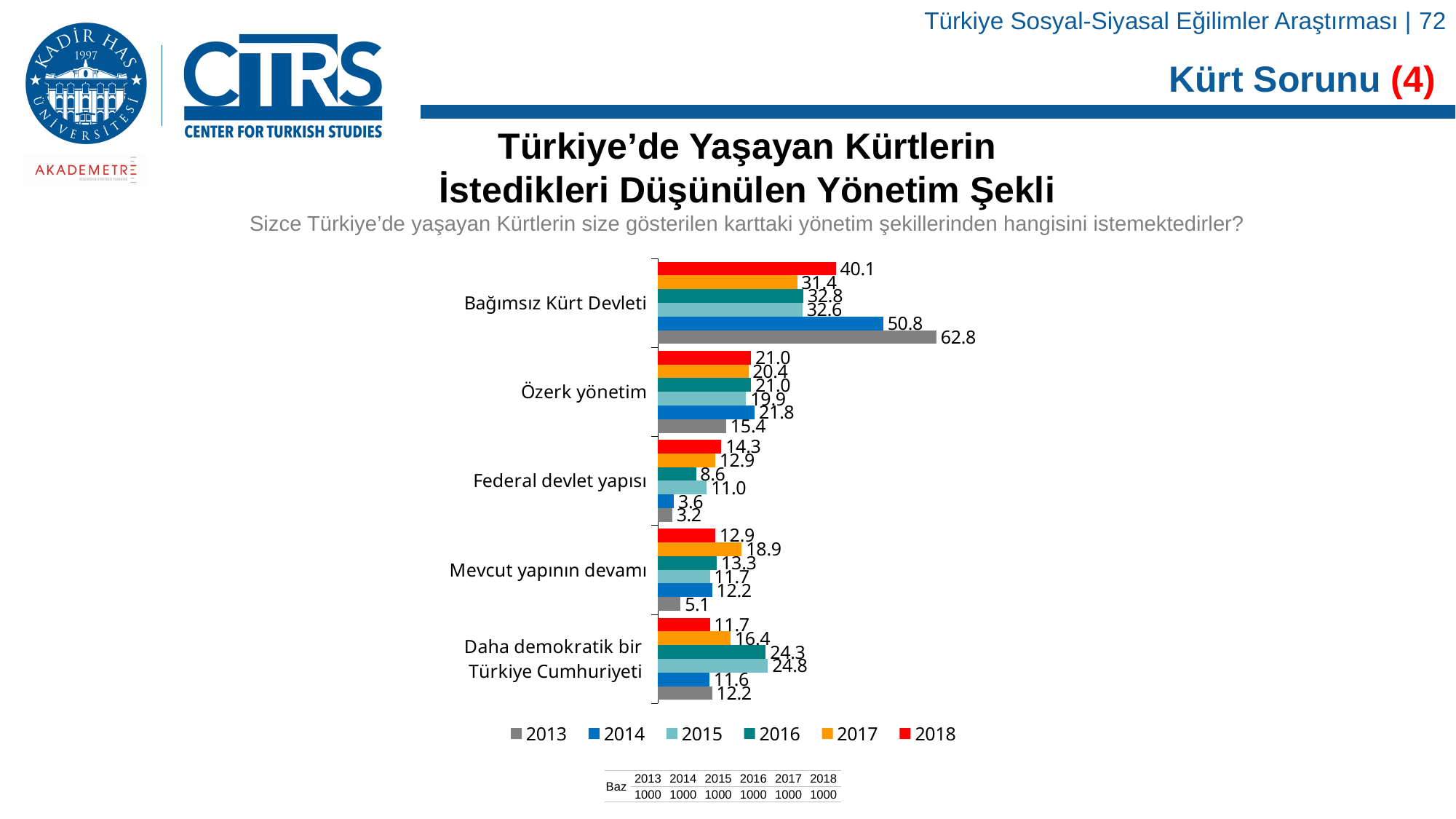
Which category has the highest 2013 value? Bağımsız Kürt Devleti Which is larger for Federal devlet yapısı: the 2018 value or the 2013 value? 2018 What kind of chart is shown on the slide? Bar chart What is the 2015 value for Daha demokratik bir Türkiye Cumhuriyeti? 24.8 What is the 2013 value for Bağımsız Kürt Devleti? 62.8 Which year is shown in red in the legend? 2018 How many categories are shown on the chart? 5 What is the 2017 value for Mevcut yapının devamı? 18.9 What is the difference between the 2013 and 2018 values for Bağımsız Kürt Devleti? 22.7 How many series does the legend list? 6 Which category has the lowest 2014 value? Federal devlet yapısı What is the 2018 value for Bağımsız Kürt Devleti? 40.1